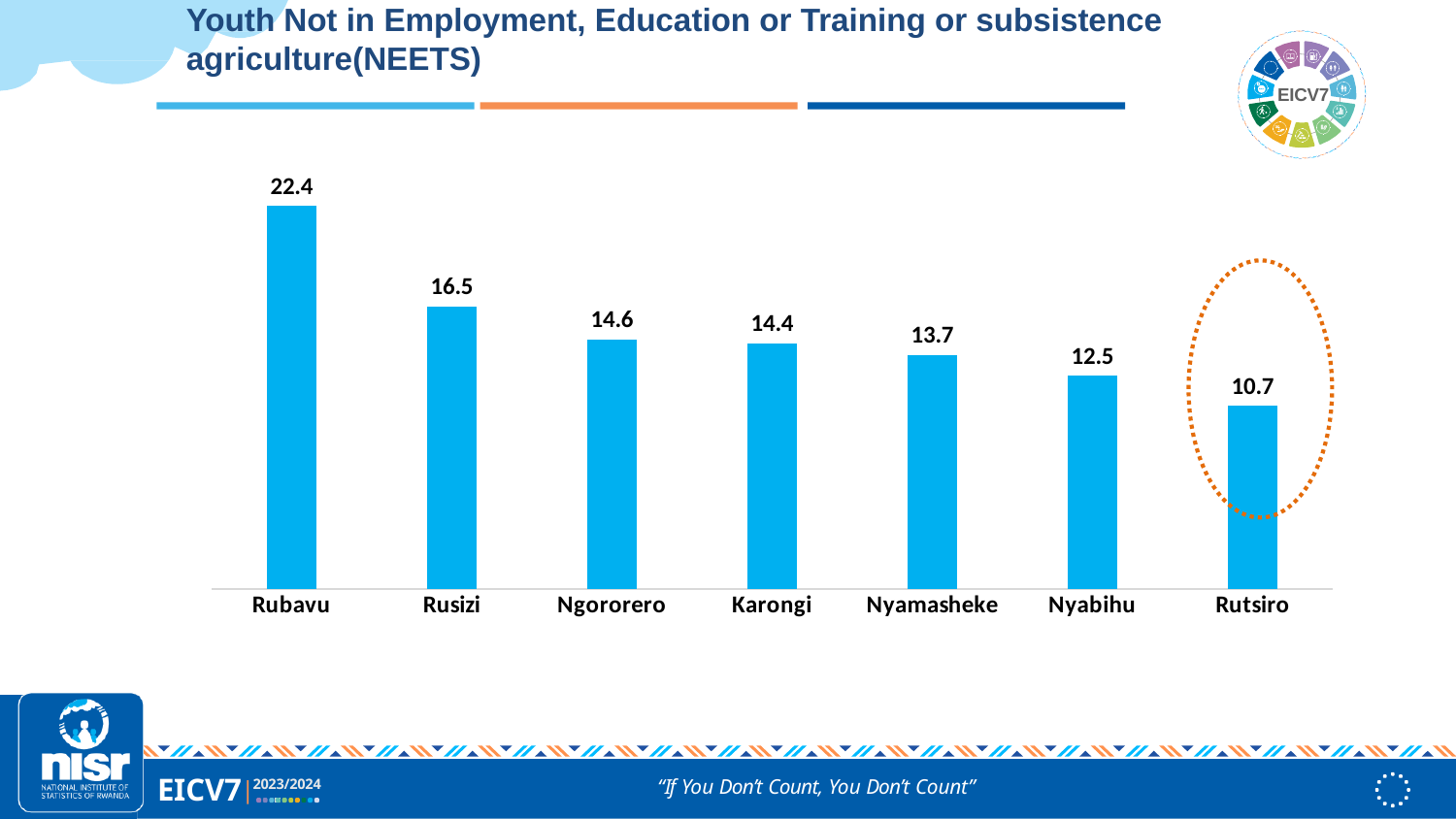
Which district has the highest value? Rubavu What is the value for Nyamasheke? 13.7 Which is larger, the value for Ngororero or the value for Nyabihu? Ngororero Do the values rise or fall from left to right across the districts? Fall How many districts are shown on the chart? 7 What is the value for Rubavu? 22.4 Which district's bar is circled with a dotted orange outline? Rutsiro What is the value for Rutsiro? 10.7 What is the difference between the values for Nyabihu and Rutsiro? 1.8 What kind of chart is shown on the slide? Bar chart Which district has the lowest value? Rutsiro What is the difference between the values for Rubavu and Rusizi? 5.9